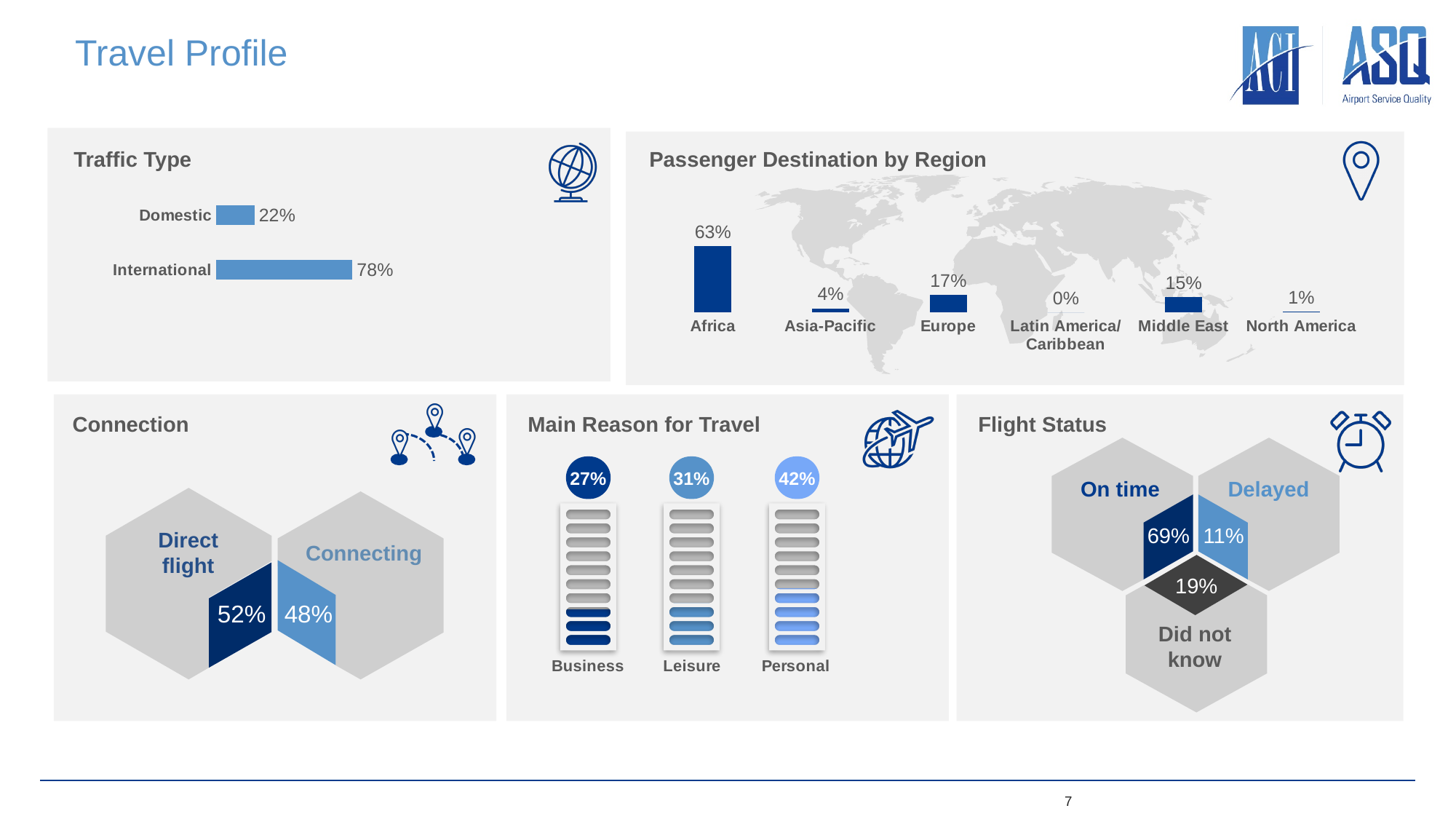
In the Passenger Destination by Region chart, what is the value for Europe? 17% In the Traffic Type chart, what is the value for International? 78% In the Main Reason for Travel chart, what is the value for Leisure? 31% In the Passenger Destination by Region chart, which region has the lowest value? Latin America/Caribbean In the Traffic Type chart, what is the value for Domestic? 22% In the Passenger Destination by Region chart, how many regions are shown? 6 In the Passenger Destination by Region chart, which is larger, Europe or Middle East? Europe In the Main Reason for Travel chart, which reason has the highest value? Personal In the Passenger Destination by Region chart, which region has the highest value? Africa In the Connection chart, what is the value for Direct flight? 52% In the Traffic Type chart, what is the difference between International and Domestic? 56% In the Flight Status chart, what is the value for Delayed? 11%